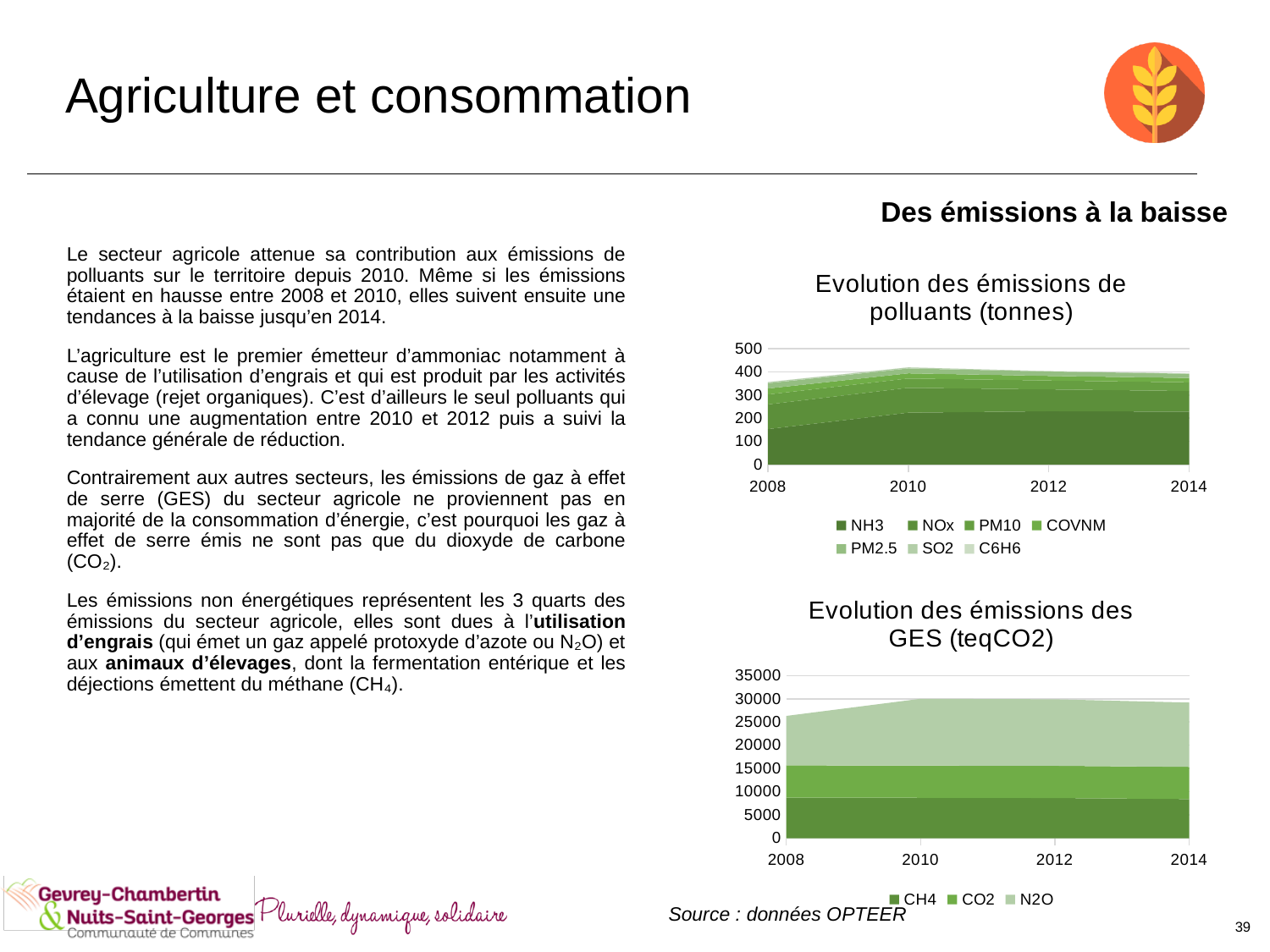
In the 'Evolution des émissions des GES (teqCO2)' chart, is the total stacked value in 2012 greater or less than 25000? greater How many series does the legend of the 'Evolution des émissions des GES (teqCO2)' chart list? 3 In the 'Evolution des émissions de polluants (tonnes)' chart, do total emissions rise or fall between 2010 and 2014? fall In the 'Evolution des émissions des GES (teqCO2)' chart, is the total stacked value in 2008 greater or less than 30000? less What is the title of the upper chart on the slide? Evolution des émissions de polluants (tonnes) What kind of chart is the 'Evolution des émissions de polluants (tonnes)' chart? Stacked area chart In the 'Evolution des émissions de polluants (tonnes)' chart, is the total stacked value in 2008 greater or less than 400? less How many series does the legend of the 'Evolution des émissions de polluants (tonnes)' chart list? 7 Which series is listed first in the legend of the 'Evolution des émissions des GES (teqCO2)' chart? CH4 In the 'Evolution des émissions des GES (teqCO2)' chart, do total emissions rise or fall between 2008 and 2010? rise How many years are labeled on the x axis of the 'Evolution des émissions des GES (teqCO2)' chart? 4